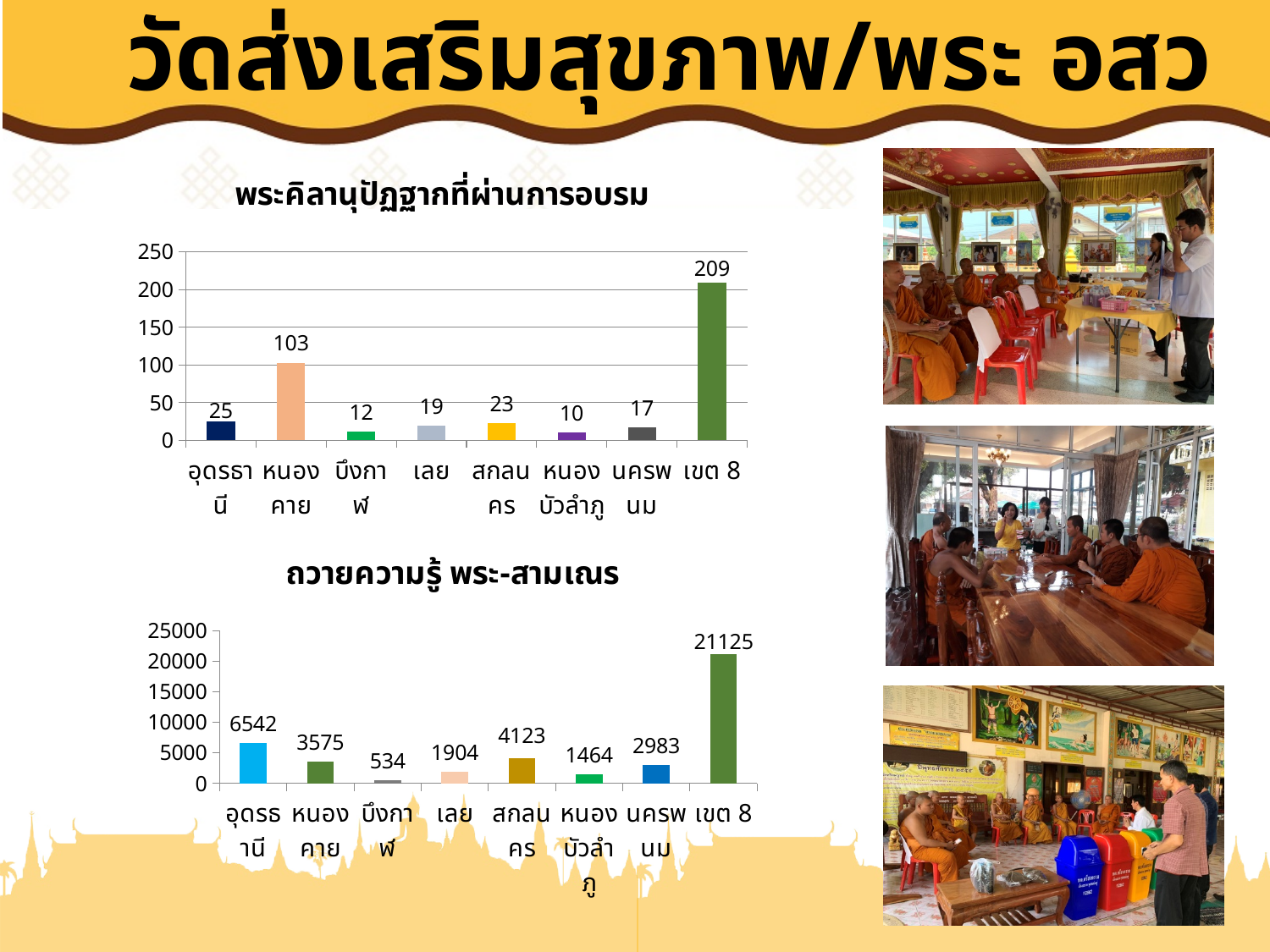
In the bottom chart (ถวายความรู้ พระ-สามเณร), what is the difference between สกลนคร and หนองคาย? 548 In the top chart (พระคิลานุปัฏฐากที่ผ่านการอบรม), what is the value for เขต 8? 209 In the top chart (พระคิลานุปัฏฐากที่ผ่านการอบรม), what is the difference between อุดรธานี and บึงกาฬ? 13 In the top chart (พระคิลานุปัฏฐากที่ผ่านการอบรม), which province has the lowest value? หนองบัวลำภู In the bottom chart (ถวายความรู้ พระ-สามเณร), what is the value for เขต 8? 21125 In the top chart (พระคิลานุปัฏฐากที่ผ่านการอบรม), which is larger, สกลนคร or นครพนม? สกลนคร In the top chart (พระคิลานุปัฏฐากที่ผ่านการอบรม), what is the value for หนองคาย? 103 In the bottom chart (ถวายความรู้ พระ-สามเณร), is the value for เขต 8 greater or less than 20000? greater What type of chart is the bottom chart (ถวายความรู้ พระ-สามเณร)? bar chart How many categories are shown on the x axis of the top chart (พระคิลานุปัฏฐากที่ผ่านการอบรม)? 8 In the bottom chart (ถวายความรู้ พระ-สามเณร), which province has the lowest value? บึงกาฬ In the bottom chart (ถวายความรู้ พระ-สามเณร), what is the value for อุดรธานี? 6542